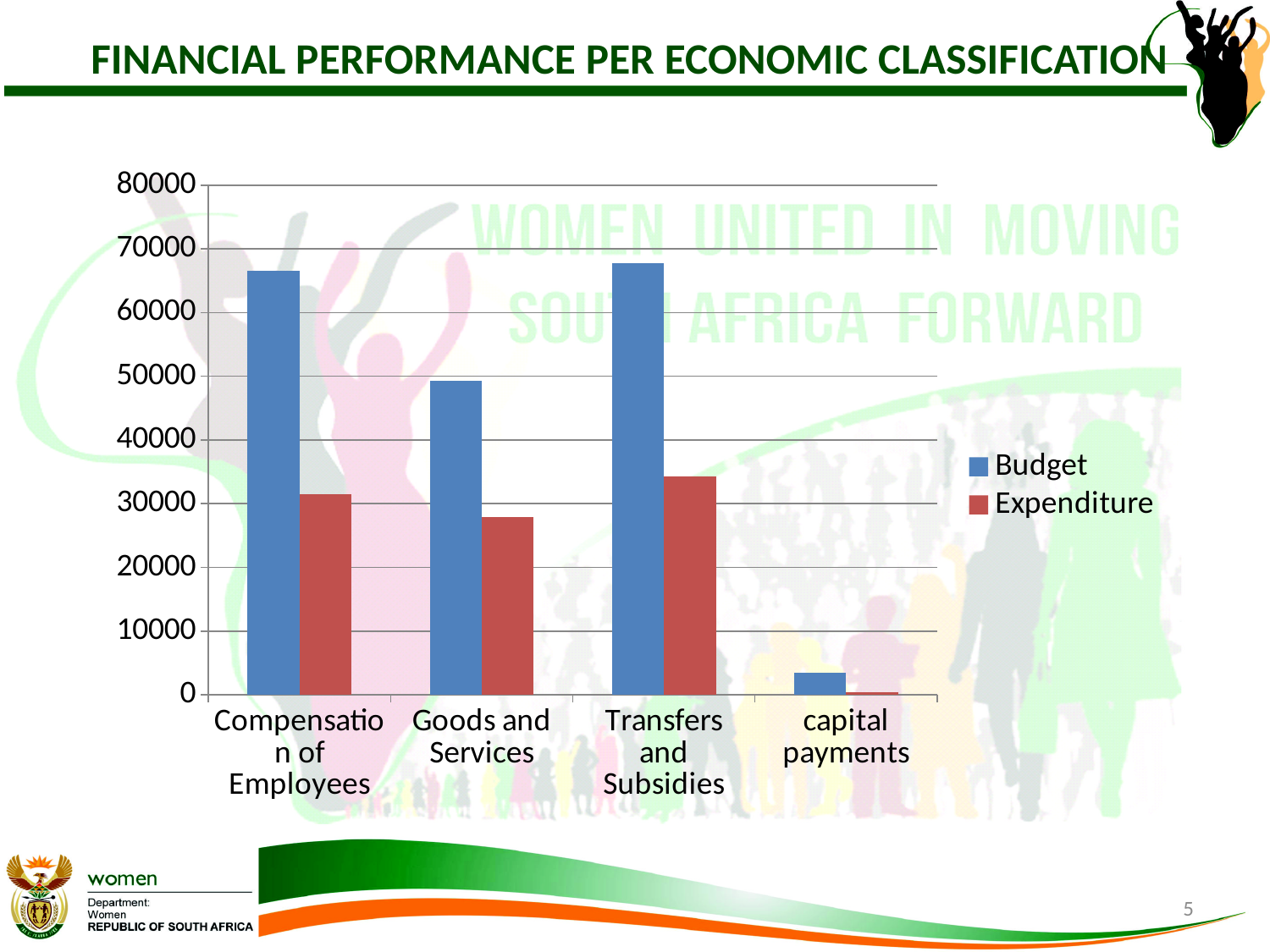
Is the Budget value for Goods and Services greater or less than 40000? greater Is the Budget value for Compensation of Employees greater or less than 60000? greater Which category has the lowest Expenditure value? capital payments For Goods and Services, which is larger: Budget or Expenditure? Budget How many economic classification categories are shown on the x axis? 4 Which category has the lowest Budget value? capital payments Which series is shown in blue in the legend? Budget Is the Budget value for capital payments greater or less than 10000? less How many series does the legend list? 2 What kind of chart is shown on the slide? bar chart